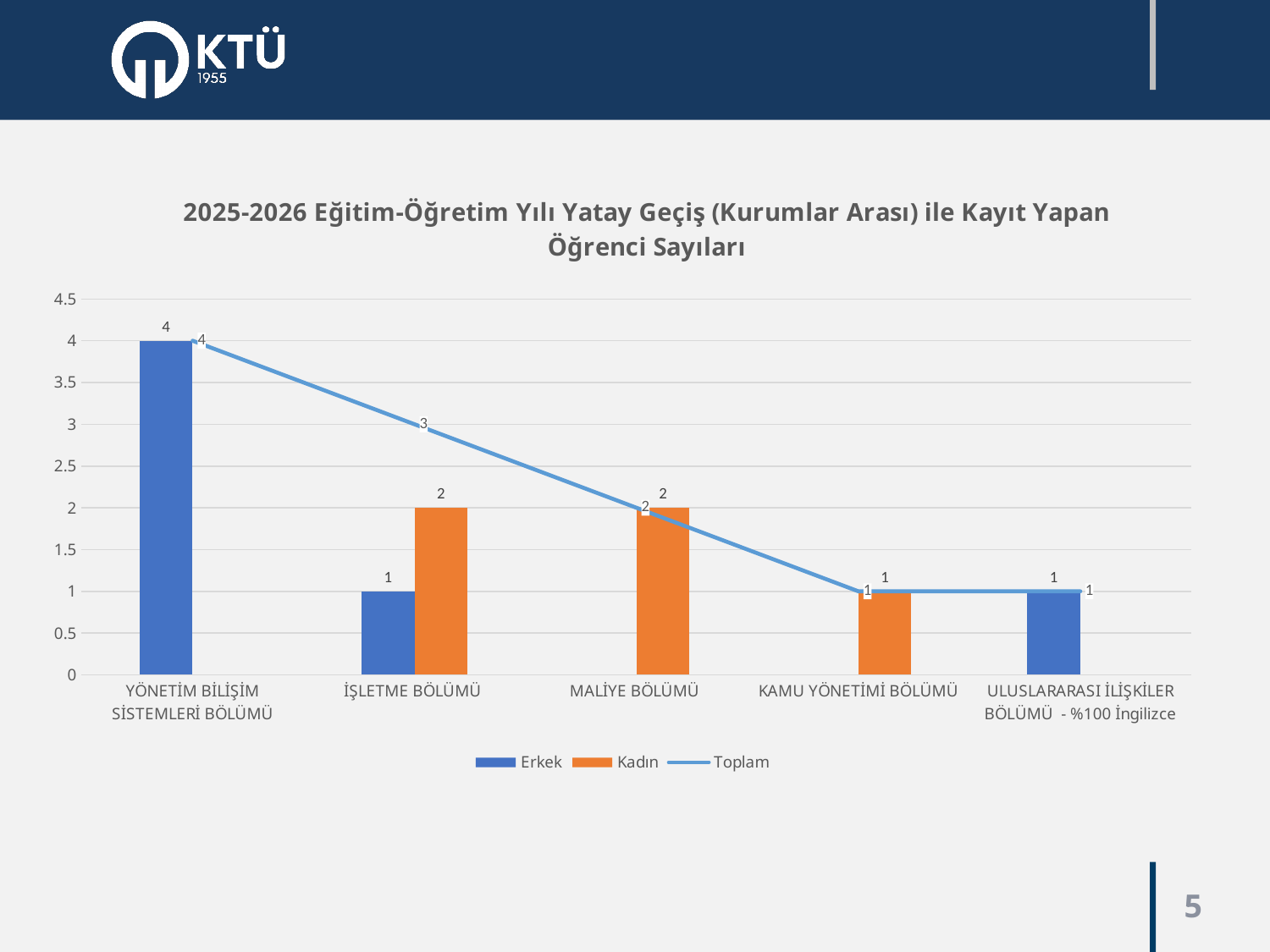
What is the difference between the Toplam values for YÖNETİM BİLİŞİM SİSTEMLERİ BÖLÜMÜ and İŞLETME BÖLÜMÜ? 1 Which is larger for İŞLETME BÖLÜMÜ, the Erkek value or the Kadın value? Kadın What is the Erkek value for ULUSLARARASI İLİŞKİLER BÖLÜMÜ - %100 İngilizce? 1 What is the Erkek value for YÖNETİM BİLİŞİM SİSTEMLERİ BÖLÜMÜ? 4 Which department has the highest Toplam value? YÖNETİM BİLİŞİM SİSTEMLERİ BÖLÜMÜ What is the Kadın value for MALİYE BÖLÜMÜ? 2 Does the Toplam line rise or fall from left to right across the departments? Fall What is the Toplam value for İŞLETME BÖLÜMÜ? 3 How many series does the legend list? 3 How many departments are shown on the x axis? 5 What is the Kadın value for İŞLETME BÖLÜMÜ? 2 What kind of chart is shown on the slide? Bar and line chart